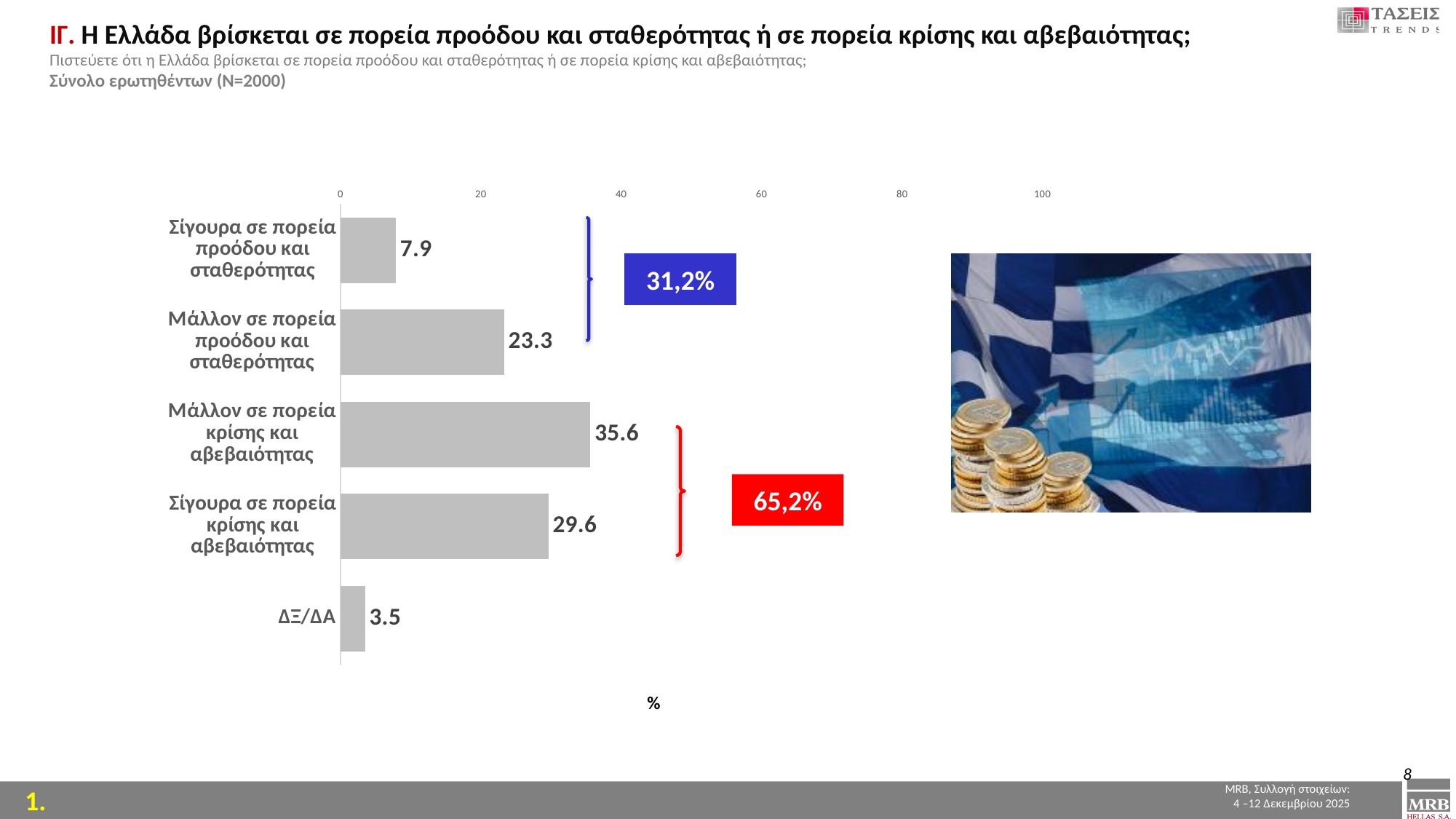
Which is larger: the value for "Μάλλον σε πορεία προόδου και σταθερότητας" or the value for "Σίγουρα σε πορεία κρίσης και αβεβαιότητας"? Σίγουρα σε πορεία κρίσης και αβεβαιότητας What combined percentage is shown in the red box for the two "κρίσης και αβεβαιότητας" categories? 65,2% What is the value for "ΔΞ/ΔΑ"? 3.5 What combined percentage is shown in the blue box for the two "προόδου και σταθερότητας" categories? 31,2% What is the value for "Μάλλον σε πορεία κρίσης και αβεβαιότητας"? 35.6 How many categories are shown in the chart? 5 What is the value for "Σίγουρα σε πορεία προόδου και σταθερότητας"? 7.9 What is the difference between the values for "Μάλλον σε πορεία κρίσης και αβεβαιότητας" and "Σίγουρα σε πορεία κρίσης και αβεβαιότητας"? 6.0 Which category has the highest value? Μάλλον σε πορεία κρίσης και αβεβαιότητας Which category has the lowest value? ΔΞ/ΔΑ Is the value for "Μάλλον σε πορεία προόδου και σταθερότητας" greater or less than 20? greater What kind of chart is shown on the slide? bar chart